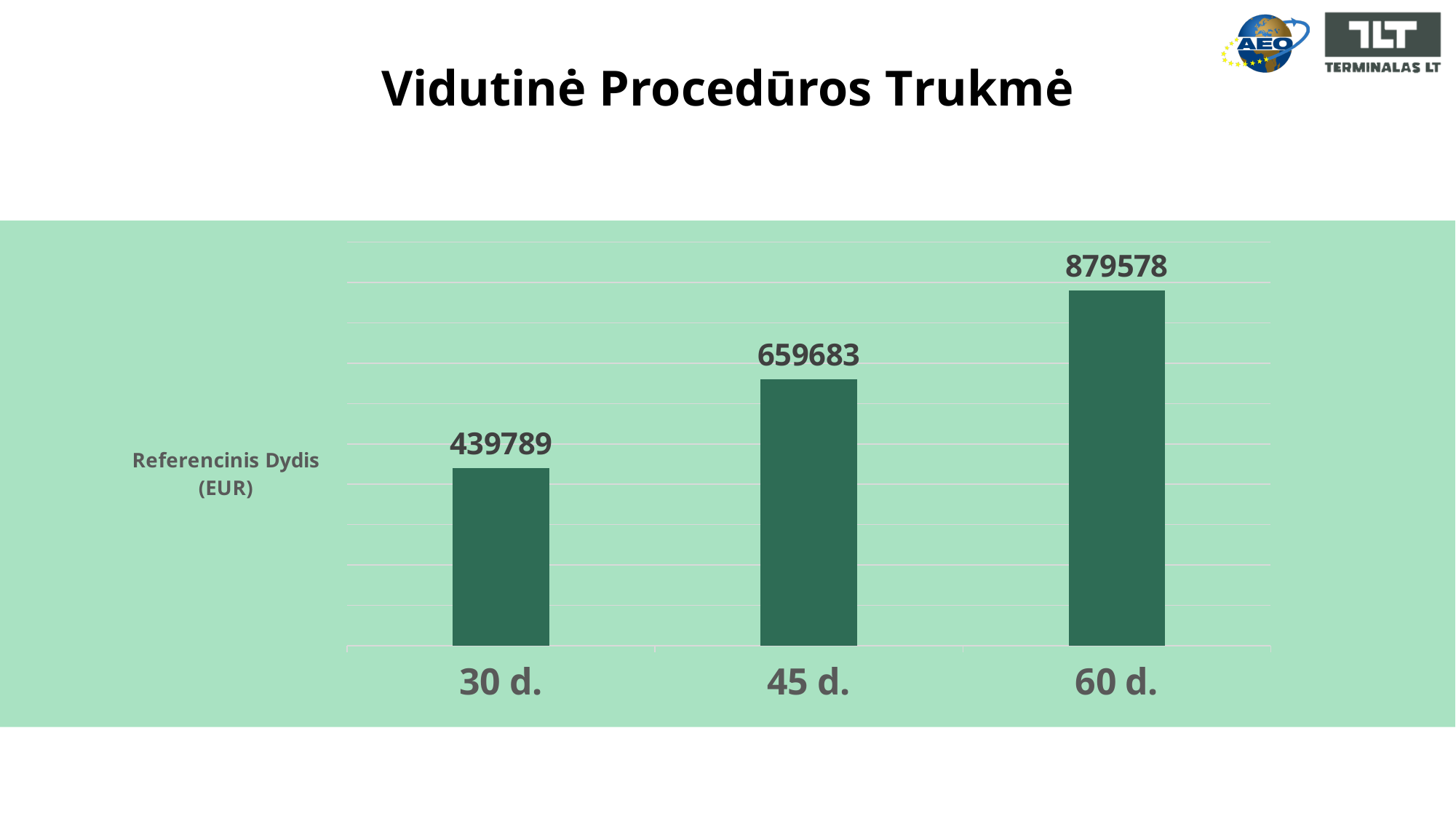
How many categories are shown on the x axis? 3 Which category has the highest value? 60 d. What is the value for 45 d.? 659683 What is the difference between the values for 45 d. and 30 d.? 219894 What is the value for 30 d.? 439789 What is the difference between the values for 60 d. and 30 d.? 439789 What is the title of the chart? Vidutinė Procedūros Trukmė What kind of chart is shown on the slide? bar chart Which category has the lowest value? 30 d. Do the values rise or fall from 30 d. to 60 d.? rise What is the value for 60 d.? 879578 Which is larger, the value for 45 d. or the value for 60 d.? 60 d.